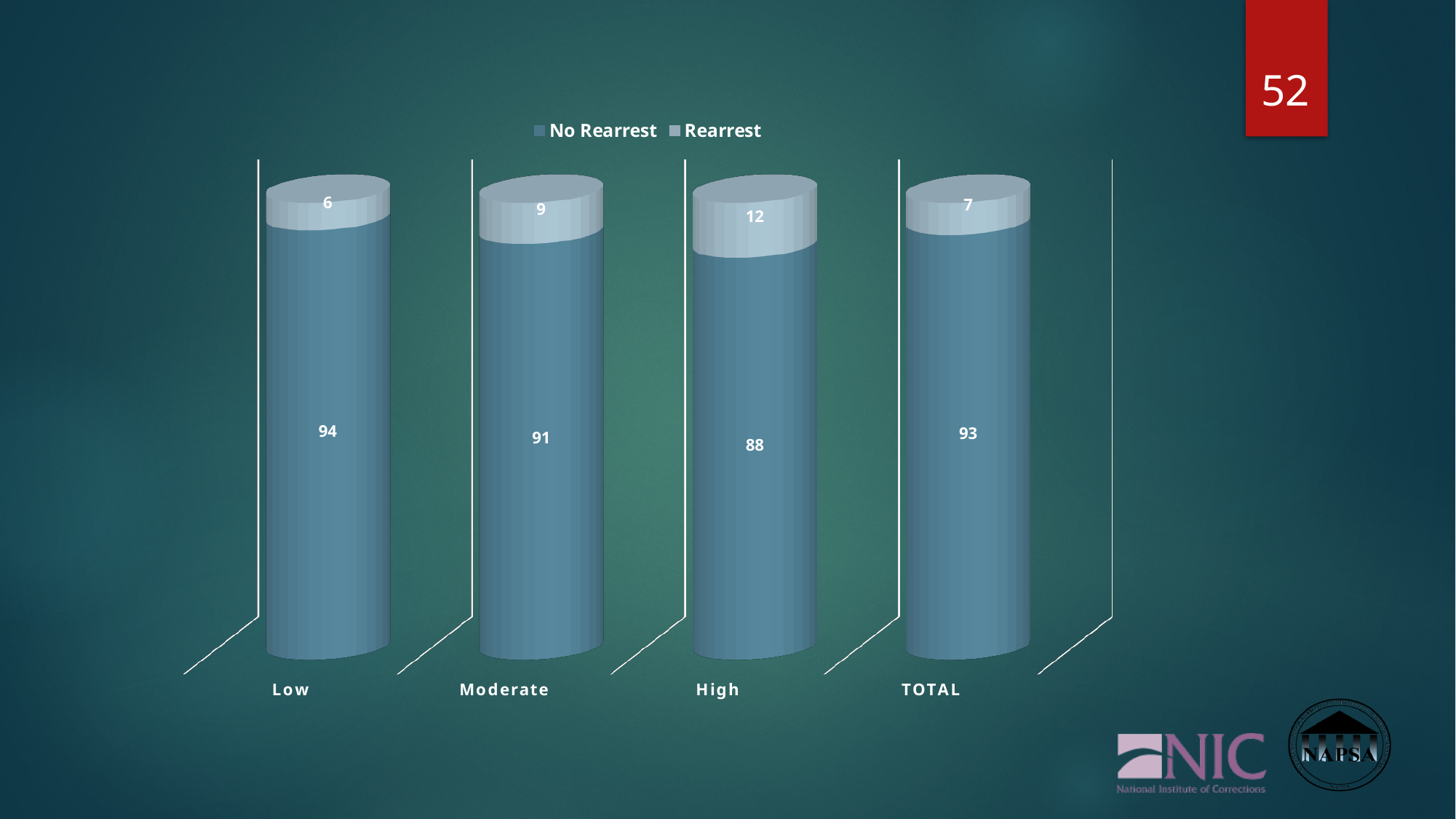
Which category has the highest Rearrest value? High What is the total of the stacked bar for the Moderate category? 100 What is the Rearrest value for the Moderate category? 9 What is the difference between the No Rearrest values for Low and High? 6 How many categories are shown on the x axis? 4 Which category has the lowest No Rearrest value? High What is the Rearrest value for the High category? 12 How many series does the legend list? 2 What is the No Rearrest value for the Low category? 94 What kind of chart is shown on the slide? Stacked bar chart Which is larger, the Rearrest value for Moderate or for TOTAL? Moderate What is the No Rearrest value for TOTAL? 93